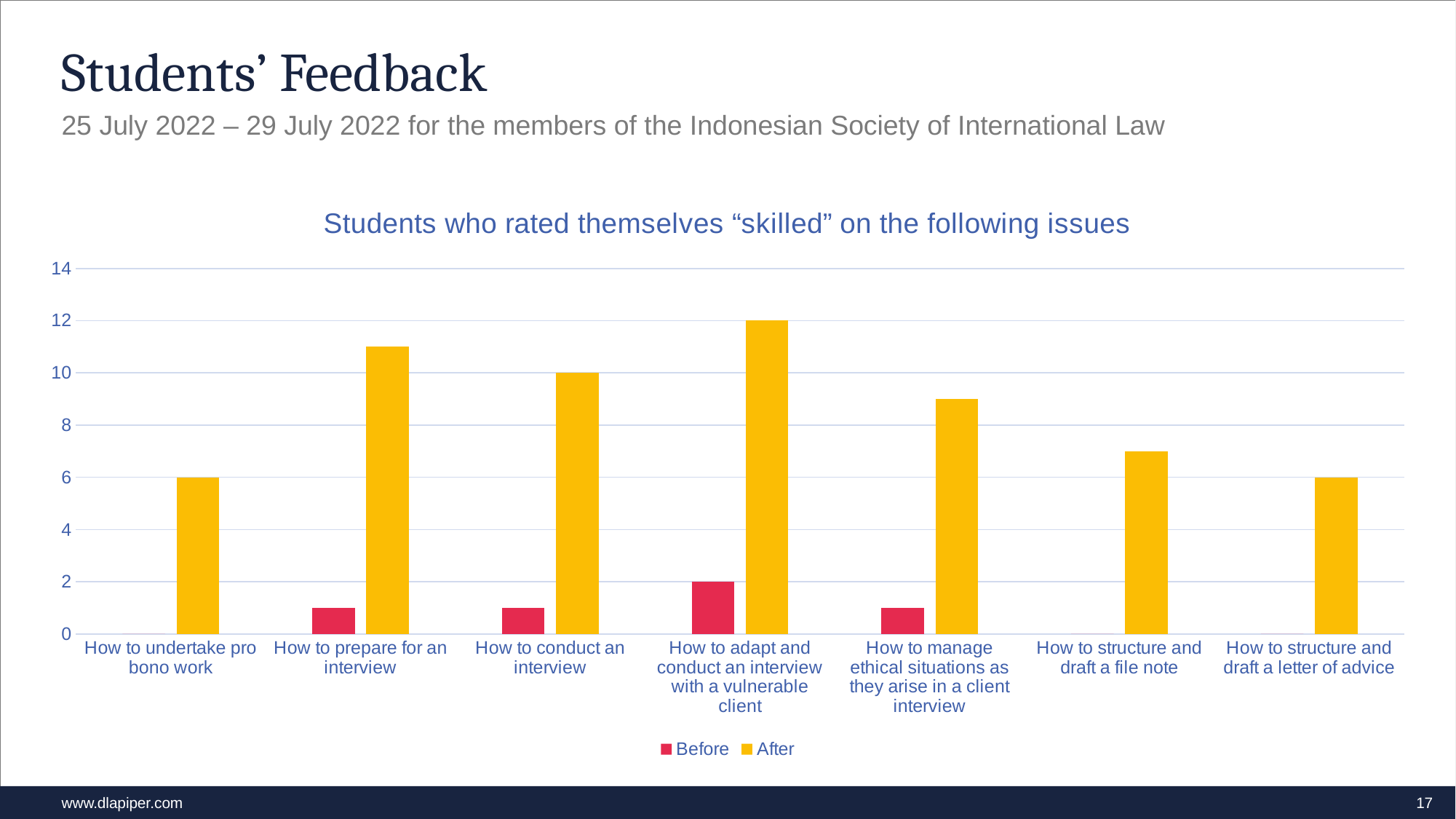
What is the Before value for "How to adapt and conduct an interview with a vulnerable client"? 2 What is the title of the chart? Students who rated themselves "skilled" on the following issues What is the After value for "How to adapt and conduct an interview with a vulnerable client"? 12 Is the After value for "How to prepare for an interview" greater or less than 10? greater What type of chart is shown on the slide? bar chart Which category has the highest After value? How to adapt and conduct an interview with a vulnerable client How many series does the legend list? 2 What is the After value for "How to undertake pro bono work"? 6 How many categories are shown on the x axis? 7 Is the After value for "How to structure and draft a file note" greater or less than 8? less What is the After value for "How to conduct an interview"? 10 Which is larger, the After value for "How to manage ethical situations as they arise in a client interview" or the After value for "How to structure and draft a letter of advice"? How to manage ethical situations as they arise in a client interview